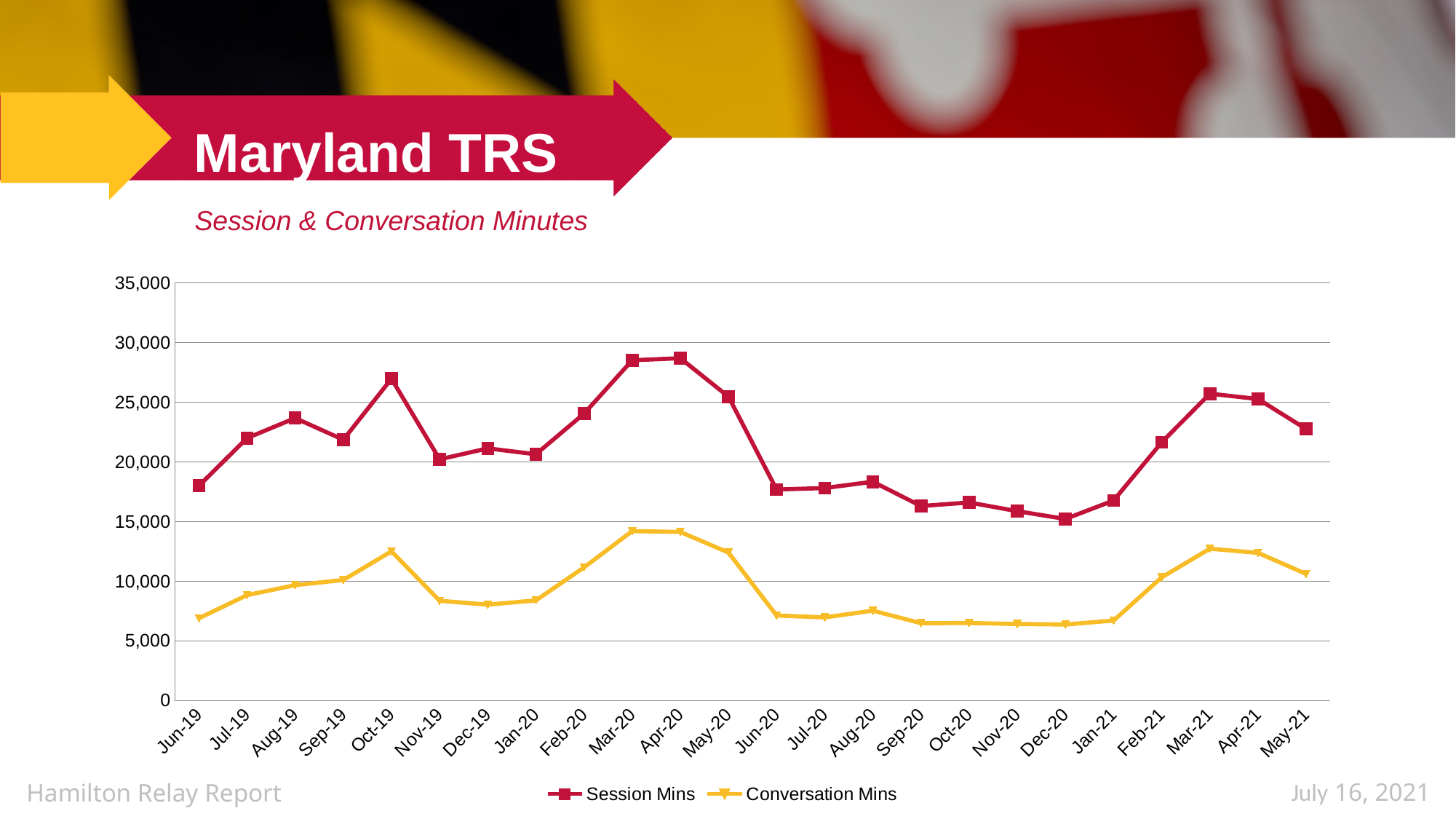
How many months are plotted along the x axis? 24 Which is larger for Conversation Mins: Mar-20 or Jun-20? Mar-20 How many series does the legend list? 2 Is the value for Session Mins in Jun-19 greater or less than 20,000? less Which month has the lowest value for Session Mins? Dec-20 Which is larger for Session Mins: Oct-19 or Nov-19? Oct-19 Is the value for Conversation Mins in Oct-19 greater or less than 10,000? greater What colour is the Conversation Mins line? Yellow Do the Session Mins values rise or fall from Dec-20 to Mar-21? rise Is the value for Conversation Mins in Jun-20 greater or less than 10,000? less What kind of chart is shown on the slide? Line chart